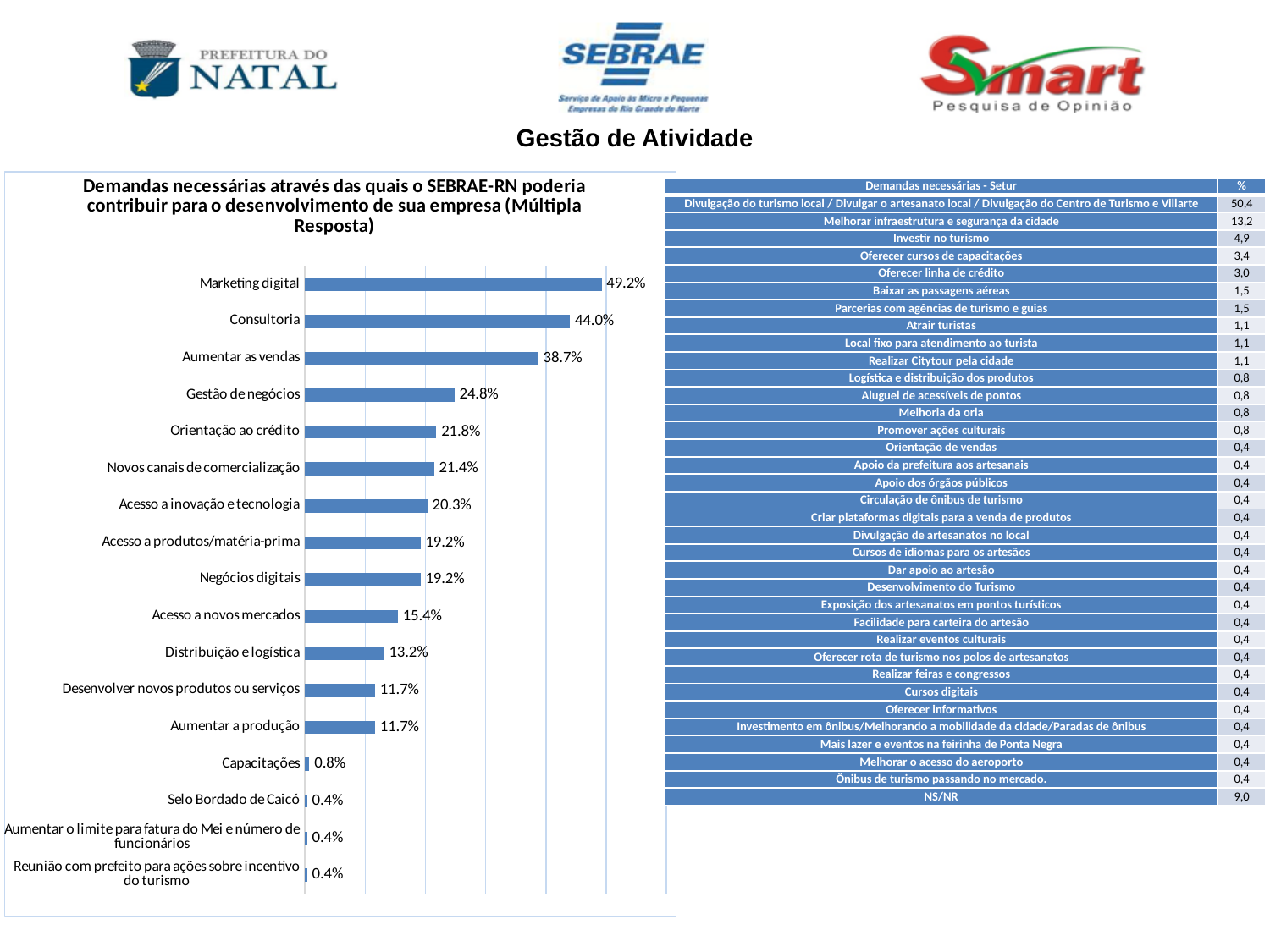
What is the difference between the values for Aumentar as vendas and Gestão de negócios? 13.9 percentage points What is the value for Marketing digital? 49.2% Do the values rise or fall going from the top category to the bottom category of the chart? Fall What kind of chart is shown on the slide? Bar chart What is the value for Gestão de negócios? 24.8% What is the value for Distribuição e logística? 13.2% How many categories are plotted in the chart? 17 What is the difference between the values for Marketing digital and Consultoria? 5.2 percentage points What is the value for Consultoria? 44.0% Which is larger, the value for Consultoria or the value for Aumentar as vendas? Consultoria What is the value for Capacitações? 0.8% Which category has the highest value in the chart? Marketing digital